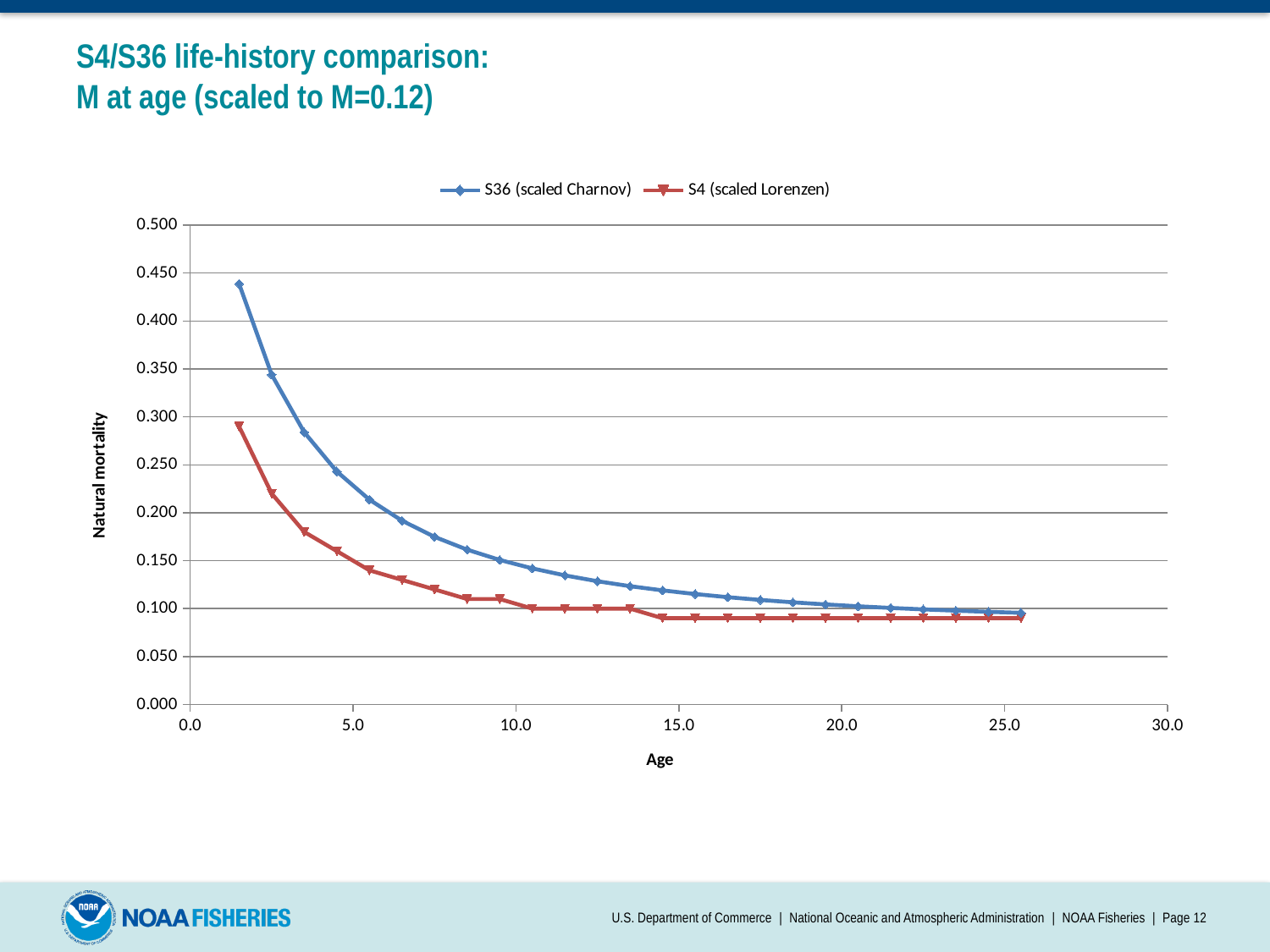
Is the natural mortality of the S4 (scaled Lorenzen) series at its youngest age greater or less than 0.250? greater What kind of chart is shown on the slide? line chart Do the values of the S4 (scaled Lorenzen) series rise or fall as age increases? fall What are the two series named in the legend? S36 (scaled Charnov) and S4 (scaled Lorenzen) Is the natural mortality of the S36 (scaled Charnov) series at age 25.0 greater or less than 0.150? less What is the label of the vertical axis? Natural mortality Is the natural mortality of the S36 (scaled Charnov) series at its youngest age greater or less than 0.400? greater How many series does the legend list? 2 At age 5.0, which series has the higher natural mortality, S36 (scaled Charnov) or S4 (scaled Lorenzen)? S36 (scaled Charnov) Do the values of the S36 (scaled Charnov) series rise or fall as age increases? fall Which series has the higher natural mortality at the youngest age plotted? S36 (scaled Charnov)